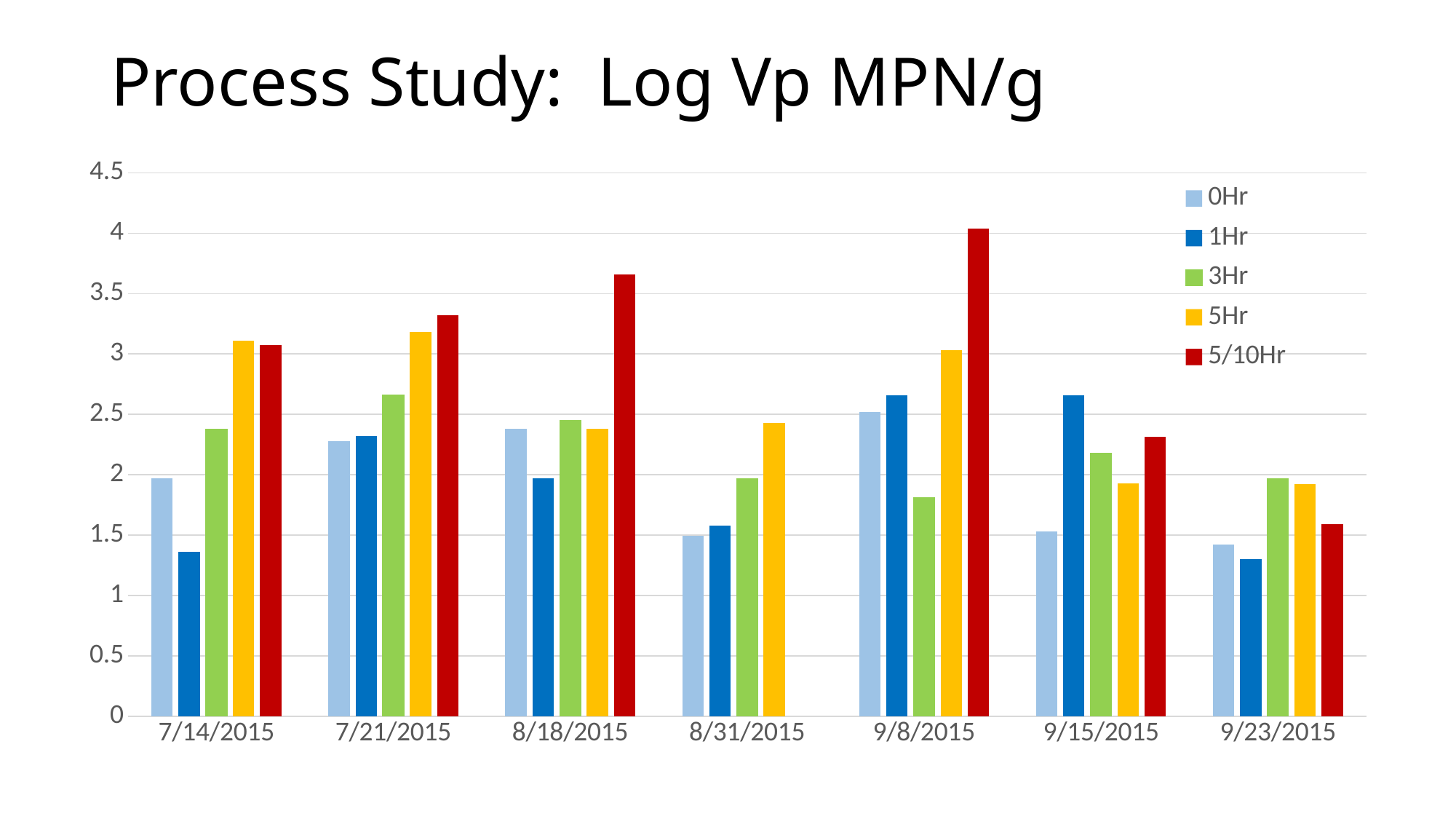
On which date is the 5/10Hr bar the highest? 9/8/2015 On 7/14/2015, which is larger: the 5Hr value or the 1Hr value? 5Hr How many bars are plotted for 8/31/2015? 4 On 9/15/2015, which is larger: the 1Hr value or the 0Hr value? 1Hr Is the value for 5/10Hr on 9/8/2015 greater or less than 3.5? greater Is the value for 1Hr on 7/14/2015 greater or less than 1.5? less On which date is the 5/10Hr bar the lowest? 9/23/2015 What kind of chart is shown on the slide? bar chart How many dates are shown on the x axis? 7 How many series does the legend list? 5 Is the value for 5/10Hr on 8/18/2015 greater or less than 3.5? greater What colour represents the 5/10Hr series in the legend? red